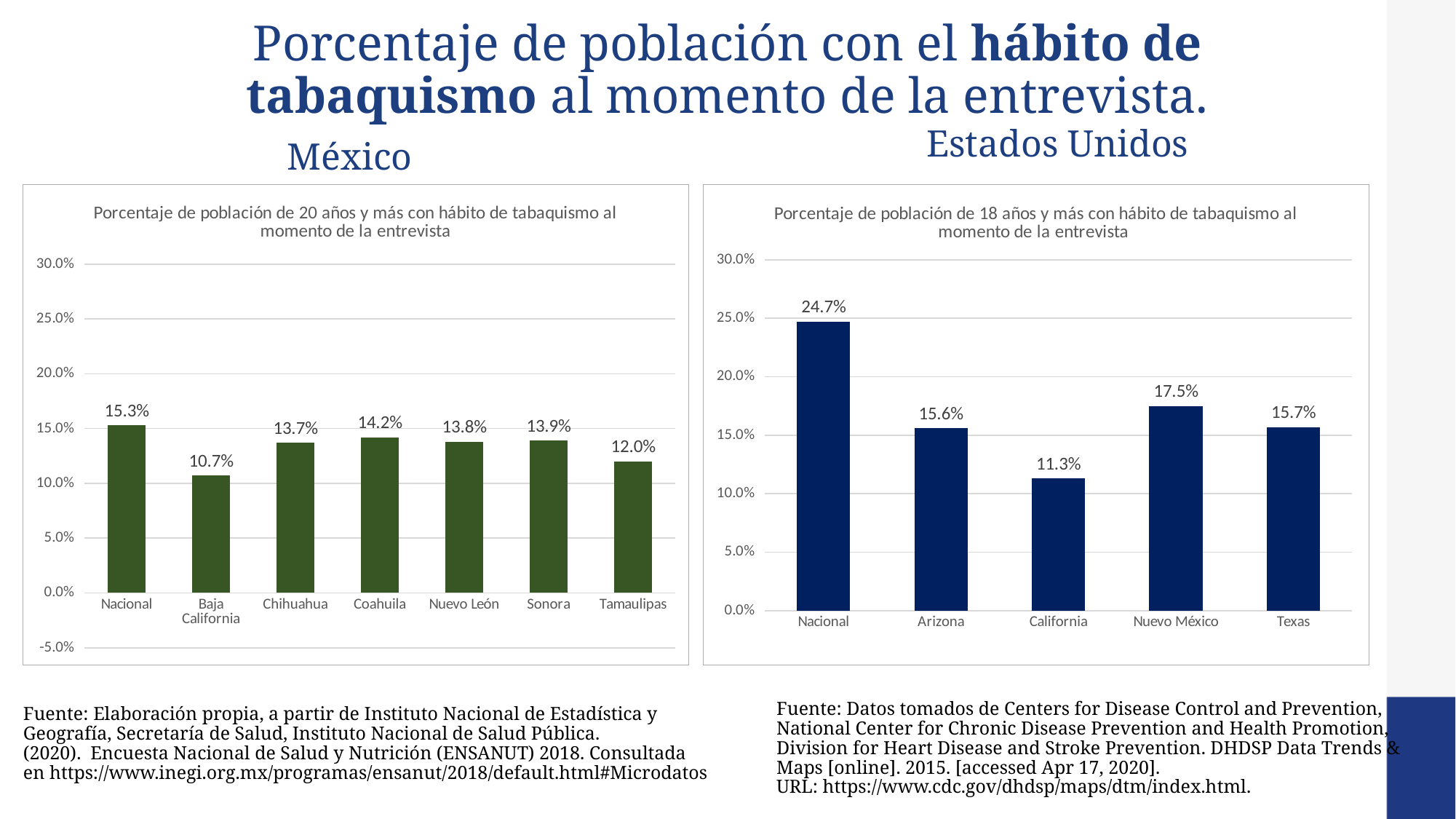
In the México chart, what is the value for Baja California? 10.7% In the Estados Unidos chart, what is the difference between Nacional and Arizona? 9.1% How many categories are shown in the México chart? 7 In the México chart, what is the difference between Nacional and Tamaulipas? 3.3% In the México chart, which category has the lowest value? Baja California What kind of chart is the Estados Unidos chart? Bar chart How many categories are shown in the Estados Unidos chart? 5 In the México chart, what is the value for Nacional? 15.3% In the México chart, which is larger, Coahuila or Chihuahua? Coahuila In the Estados Unidos chart, what is the value for Nuevo México? 17.5% In the Estados Unidos chart, which category has the highest value? Nacional In the Estados Unidos chart, what is the value for California? 11.3%